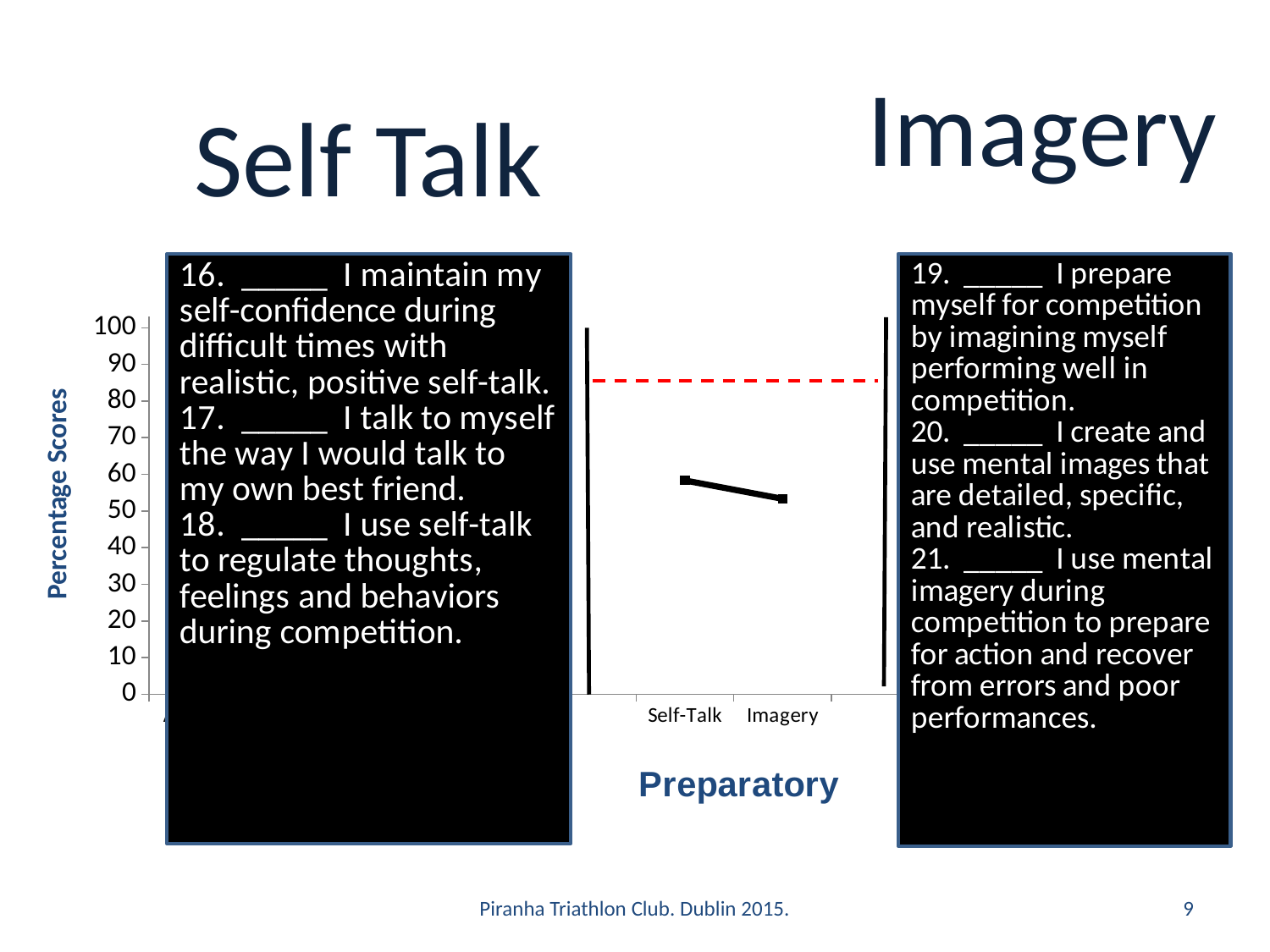
What is the maximum value shown on the vertical axis? 100 Is the value for Imagery greater or less than 40? greater Which has the higher value, Self-Talk or Imagery? Self-Talk Is the value for Imagery greater or less than 60? less Is the value for Self-Talk greater or less than 50? greater What is the title of the vertical axis? Percentage Scores What kind of chart is shown on the slide? line chart Does the plotted line rise or fall from Self-Talk to Imagery? fall